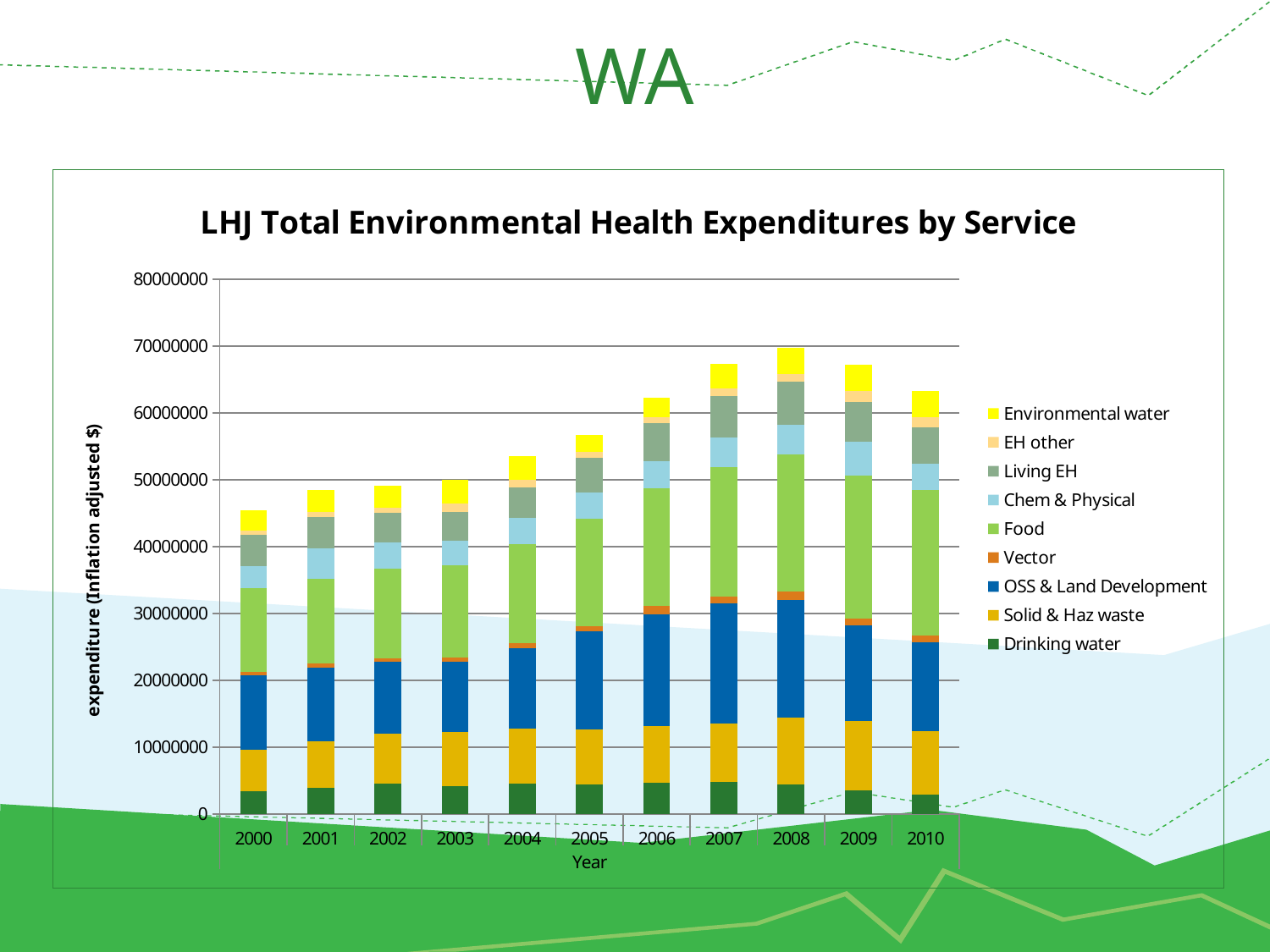
Which year has the highest total expenditure? 2008 How many years are shown on the x axis of the chart? 11 Which year has the lowest total expenditure? 2000 How many series does the legend list? 9 Which year has the larger total expenditure, 2003 or 2006? 2006 Do the total expenditures rise or fall from 2000 to 2008? rise Is the total expenditure for 2008 greater or less than 60000000? greater What is the label on the y axis of the chart? expenditure (Inflation adjusted $) What is the title of the chart? LHJ Total Environmental Health Expenditures by Service What kind of chart is shown on the slide? Stacked bar chart Is the total expenditure for 2005 greater or less than 50000000? greater Is the total expenditure for 2000 greater or less than 50000000? less